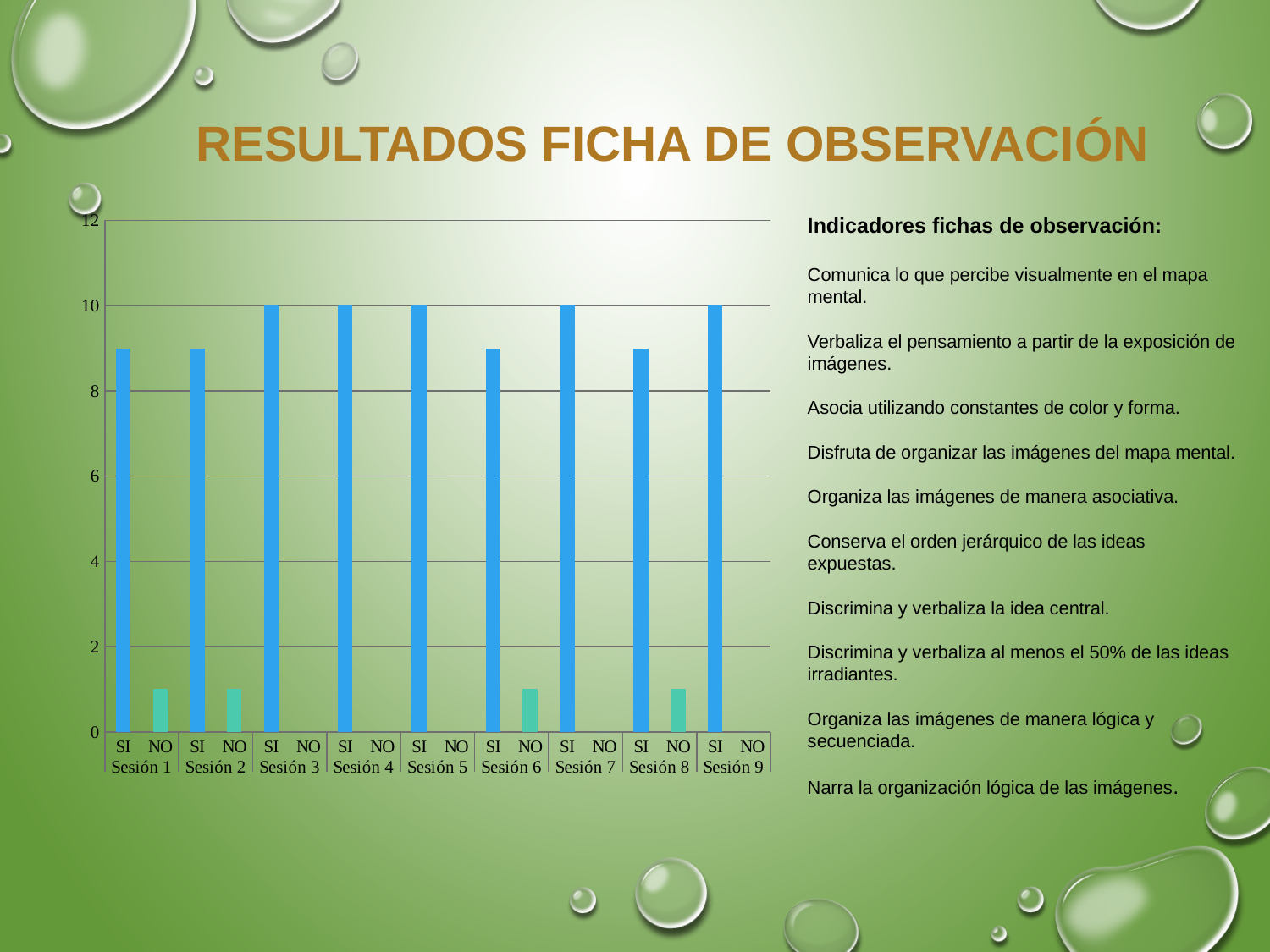
Which is larger for Sesión 8, the SI bar or the NO bar? SI Is the value of the SI bar for Sesión 1 greater or less than 8? greater Is the value of the SI bar for Sesión 5 greater or less than 8? greater What is the highest value shown on the vertical axis of the chart? 12 Is the value of the NO bar for Sesión 2 greater or less than 2? less What is the title of the slide containing the chart? RESULTADOS FICHA DE OBSERVACIÓN What kind of chart is shown on the slide? bar chart What is the value of the SI bar for Sesión 9? 10 How many sessions (Sesión) are shown on the x axis of the chart? 9 Which is larger, the SI bar for Sesión 4 or the SI bar for Sesión 1? Sesión 4 What is the value of the SI bar for Sesión 3? 10